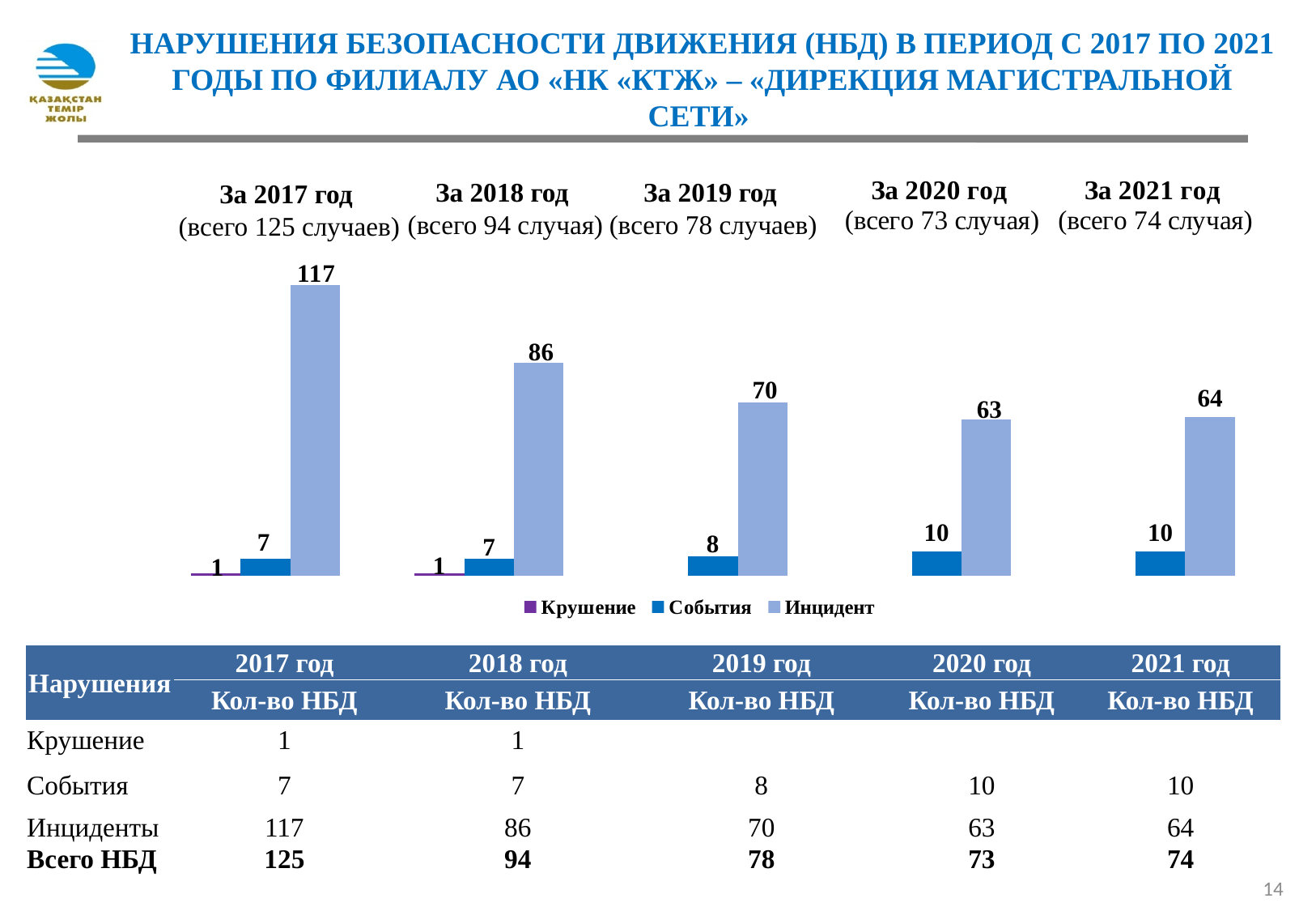
What type of chart is shown on the slide? bar chart What is the value of Крушение for 2018 (За 2018 год)? 1 Which series in the legend is shown in purple? Крушение Which is larger: the Инцидент value for 2020 or for 2021? 2021 What is the value of Инцидент for 2017 (За 2017 год)? 117 What is the value of События for 2019 (За 2019 год)? 8 In which year is the Инцидент value the highest? 2017 How many series does the chart legend list? 3 How many year groups are shown on the x axis of the chart? 5 In which year is the Инцидент value the lowest? 2020 What is the difference between the Инцидент values for 2017 and 2018? 31 Does the Инцидент value rise or fall from 2017 to 2020? fall